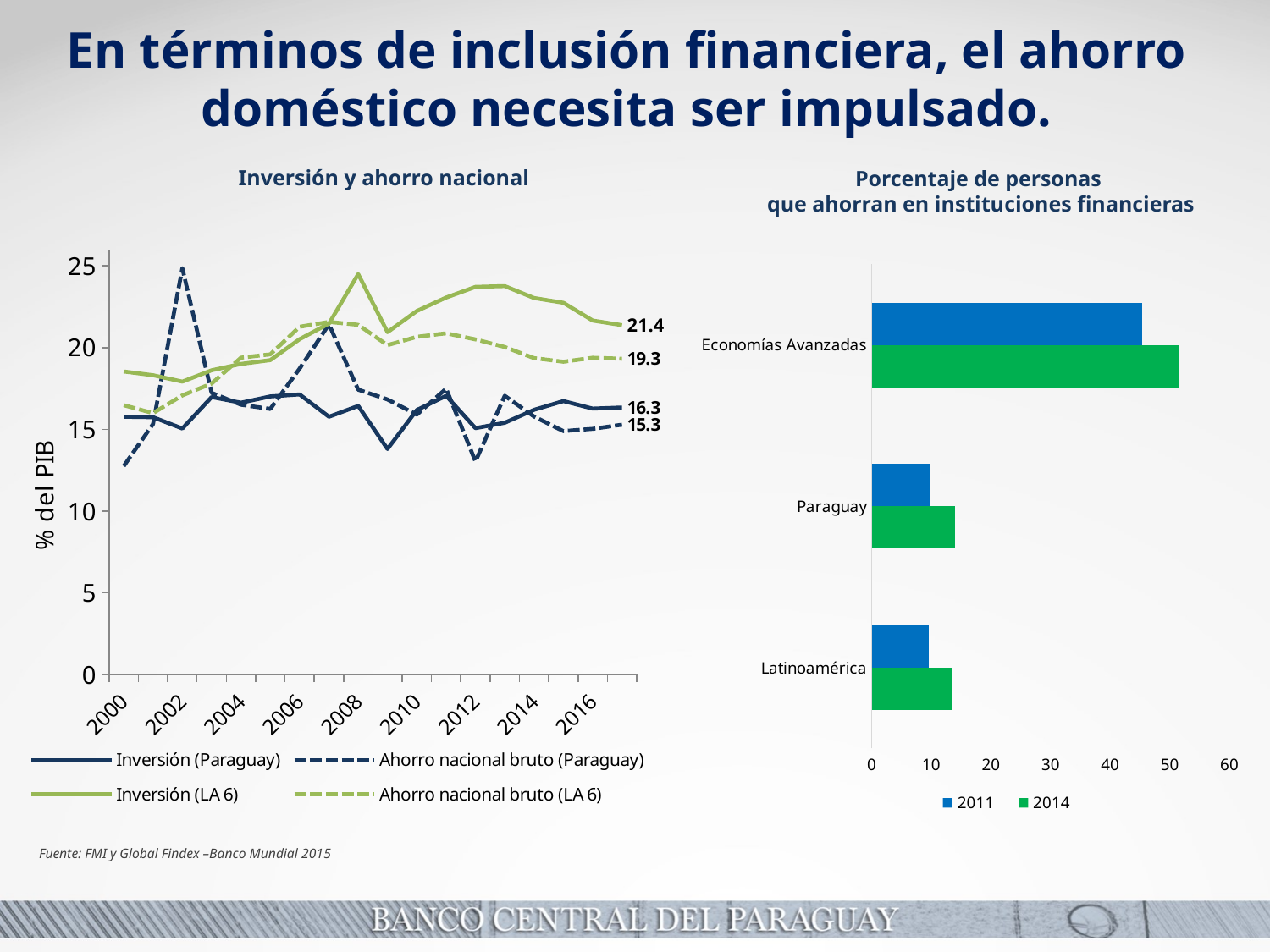
In the 'Inversión y ahorro nacional' chart, what is the difference between the labelled end values of Inversión (LA 6) and Inversión (Paraguay)? 5.1 In the 'Porcentaje de personas que ahorran en instituciones financieras' chart, how many categories are shown? 3 What is the y-axis label of the 'Inversión y ahorro nacional' chart? % del PIB In the 'Porcentaje de personas que ahorran en instituciones financieras' chart, for Economías Avanzadas, which is larger: the 2011 value or the 2014 value? 2014 In the 'Inversión y ahorro nacional' chart, what is the labelled end value of the Ahorro nacional bruto (Paraguay) series? 15.3 In the 'Inversión y ahorro nacional' chart, how many series does the legend list? 4 In the 'Porcentaje de personas que ahorran en instituciones financieras' chart, how many series does the legend list? 2 What kind of chart is the left-hand chart, 'Inversión y ahorro nacional'? line chart What kind of chart is the right-hand chart, 'Porcentaje de personas que ahorran en instituciones financieras'? bar chart In the 'Inversión y ahorro nacional' chart, what is the labelled end value of the Inversión (LA 6) series? 21.4 In the 'Porcentaje de personas que ahorran en instituciones financieras' chart, which category has the highest value for 2014? Economías Avanzadas In the 'Porcentaje de personas que ahorran en instituciones financieras' chart, is the 2014 value for Paraguay greater or less than 10? greater